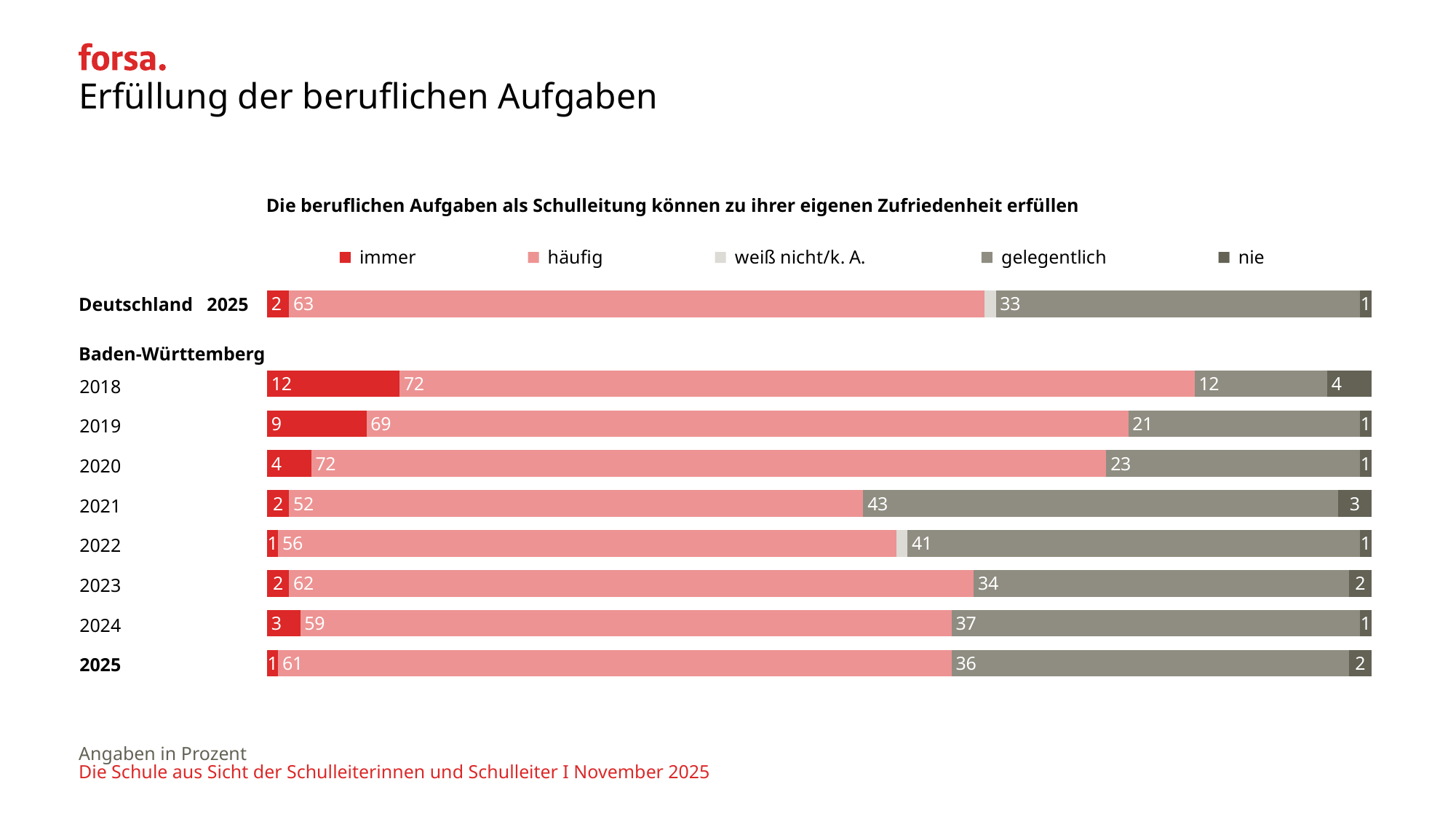
What kind of chart is shown on the slide? stacked bar chart What is the value for "häufig" for Deutschland 2025? 63 What is the difference between the "gelegentlich" values for Baden-Württemberg in 2021 and 2018? 31 How many series does the legend list? 5 Which is larger: the "häufig" value for Baden-Württemberg in 2024 or in 2025? 2025 How many bars are shown in the chart? 9 What is the value for "immer" for Baden-Württemberg in 2018? 12 What is the value for "nie" for Baden-Württemberg in 2025? 2 Does the value for "immer" in Baden-Württemberg rise or fall from 2018 to 2020? fall In which Baden-Württemberg year is the value for "immer" highest? 2018 In which Baden-Württemberg year is the value for "häufig" lowest? 2021 What is the value for "gelegentlich" for Baden-Württemberg in 2021? 43